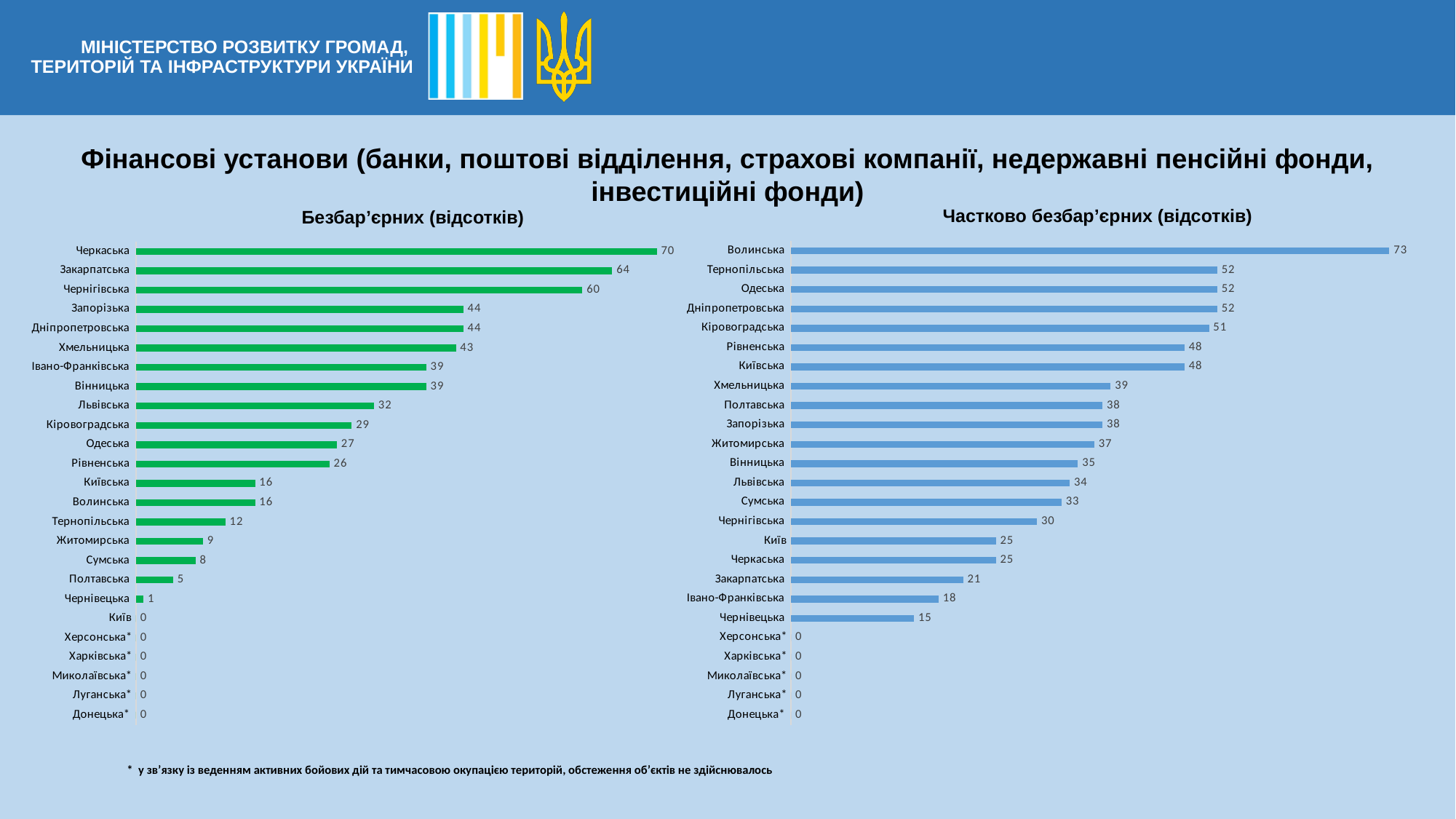
In the chart "Безбар’єрних (відсотків)", which region has the highest value? Черкаська In the chart "Безбар’єрних (відсотків)", which is larger: the value for Кіровоградська or the value for Рівненська? Кіровоградська What type of chart is the chart "Частково безбар’єрних (відсотків)"? Bar chart How many regions are listed in the chart "Безбар’єрних (відсотків)"? 25 In the chart "Частково безбар’єрних (відсотків)", which region has the highest value? Волинська In the chart "Безбар’єрних (відсотків)", what is the value for Чернігівська? 60 In the chart "Частково безбар’єрних (відсотків)", what is the difference between the values for Волинська and Чернівецька? 58 What colour are the bars in the chart "Безбар’єрних (відсотків)"? Green In the chart "Безбар’єрних (відсотків)", what is the difference between the values for Закарпатська and Львівська? 32 In the chart "Частково безбар’єрних (відсотків)", which is larger: the value for Сумська or the value for Черкаська? Сумська In the chart "Безбар’єрних (відсотків)", what is the value for Полтавська? 5 In the chart "Частково безбар’єрних (відсотків)", what is the value for Житомирська? 37